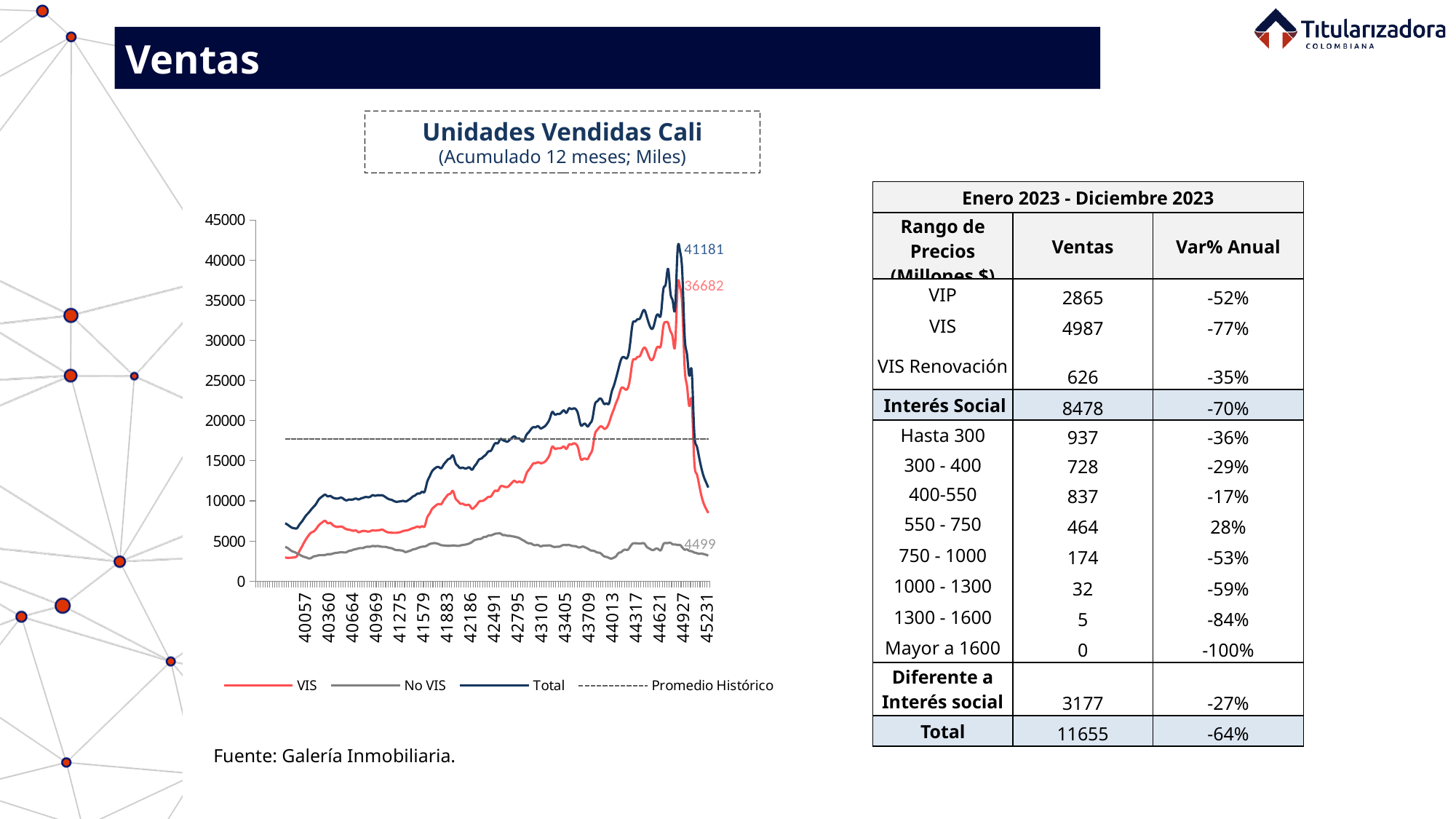
What value is labeled on the No VIS series in the 'Unidades Vendidas Cali' chart? 4499 How many series does the legend of the 'Unidades Vendidas Cali' chart list? 4 What is the labeled peak value of the Total series in the 'Unidades Vendidas Cali' chart? 41181 Is the Promedio Histórico line in the 'Unidades Vendidas Cali' chart greater or less than 20000? less What is the labeled peak value of the VIS series in the 'Unidades Vendidas Cali' chart? 36682 What colour is the Total series line in the 'Unidades Vendidas Cali' chart? dark blue In the 'Unidades Vendidas Cali' chart, does the Total series rise or fall from the start of the x axis up to its labeled peak of 41181? rise Which series reaches the highest labeled value in the 'Unidades Vendidas Cali' chart? Total What kind of chart is 'Unidades Vendidas Cali'? line chart What is the difference between the labeled peak of Total (41181) and the labeled peak of VIS (36682) in the 'Unidades Vendidas Cali' chart? 4499 Is the Promedio Histórico line in the 'Unidades Vendidas Cali' chart greater or less than 15000? greater